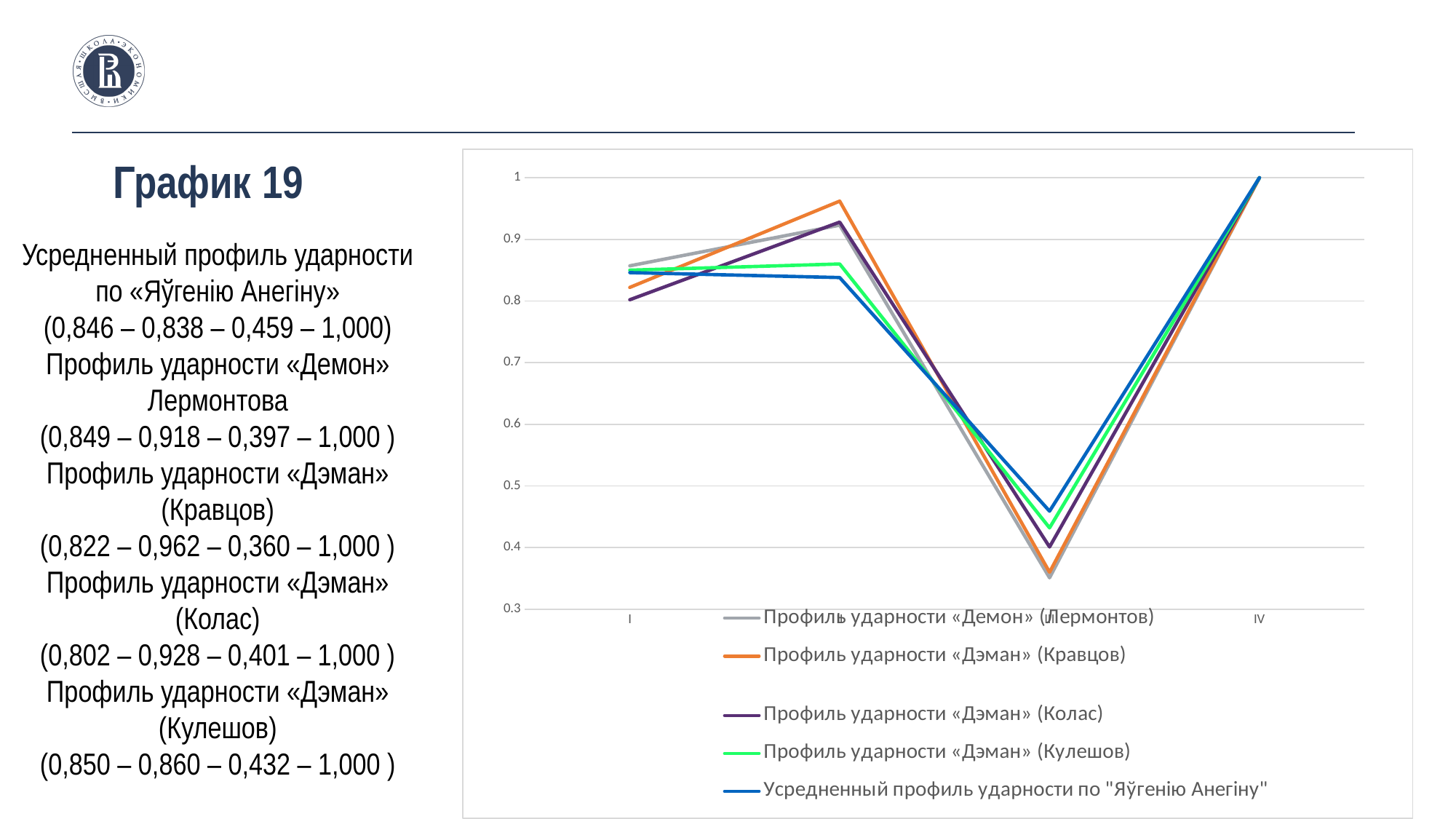
At point I, which is larger: «Профиль ударности «Дэман» (Кулешов)» or «Профиль ударности «Дэман» (Колас)»? Профиль ударности «Дэман» (Кулешов) What colour is the line for «Усредненный профиль ударности по «Яўгенію Анегіну»»? blue Is the value of «Усредненный профиль ударности по «Яўгенію Анегіну»» at point III greater or less than 0.5? less What kind of chart is shown on the slide? line chart What is the difference between the values of «Профиль ударности «Дэман» (Кравцов)» at point II and at point III? 0,602 What is the value of «Профиль ударности «Дэман» (Кравцов)» at point II? 0,962 Which series has the highest value at point II? Профиль ударности «Дэман» (Кравцов) What is the value of «Усредненный профиль ударности по «Яўгенію Анегіну»» at point III? 0,459 Which series has the lowest value at point III? Профиль ударности «Демон» (Лермонтов) How many points along the x axis does each line have? 4 Do the lines rise or fall from point III to point IV? rise How many series does the legend list? 5